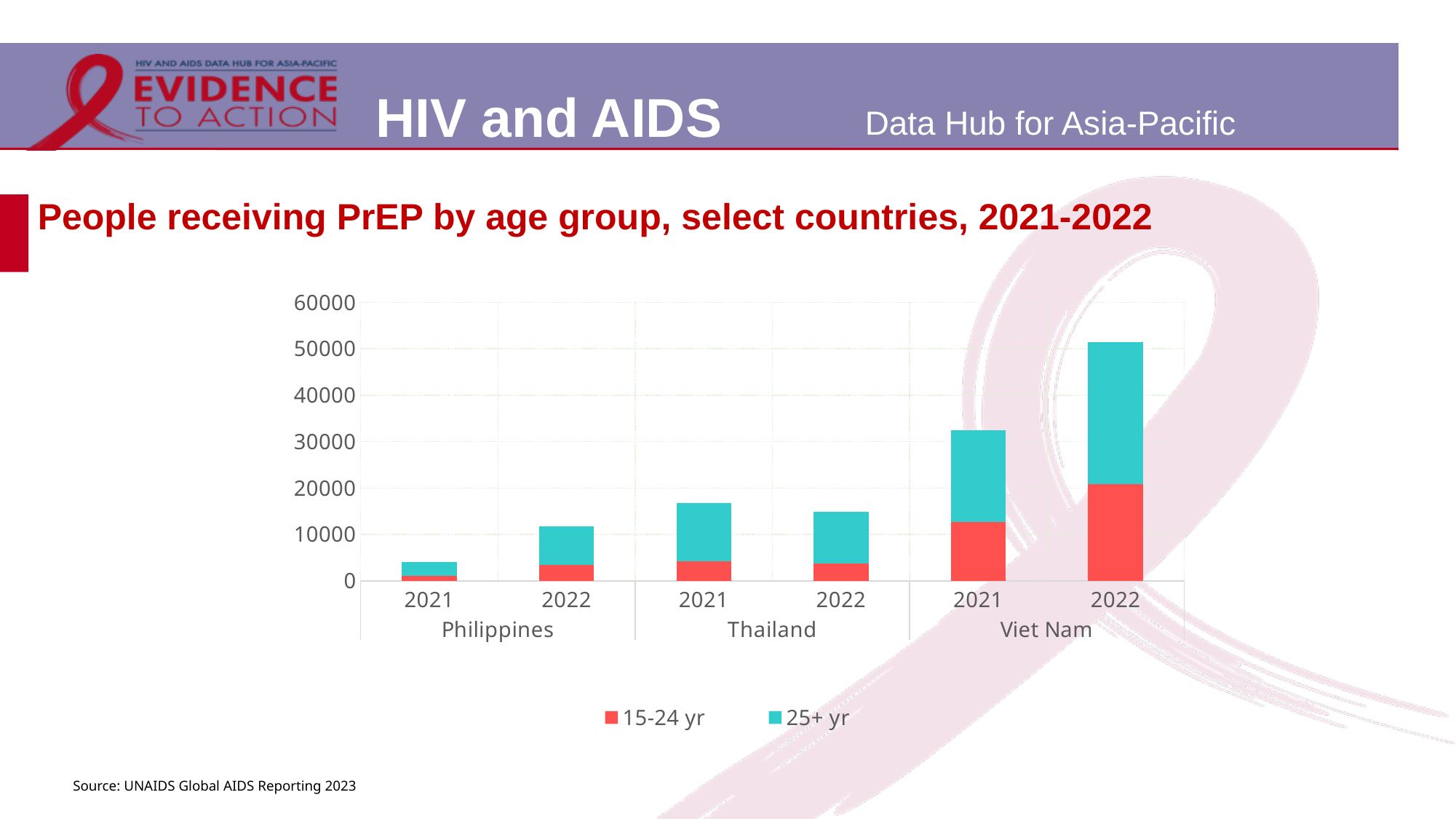
Did the total number of people receiving PrEP in Viet Nam rise or fall from 2021 to 2022? Rise Is the total for Viet Nam in 2022 greater or less than 50000? greater Which is larger, the total for Thailand in 2021 or Thailand in 2022? Thailand 2021 Which country and year has the shortest stacked bar? Philippines 2021 Is the total for Viet Nam in 2021 greater or less than 30000? greater How many countries are shown on the x axis? 3 Which country and year has the tallest stacked bar? Viet Nam 2022 What kind of chart is shown on the slide? Stacked bar chart How many bars are plotted in the chart? 6 What are the two age groups listed in the legend? 15-24 yr and 25+ yr Is the total for Philippines in 2022 greater or less than 20000? less How many series does the legend list? 2